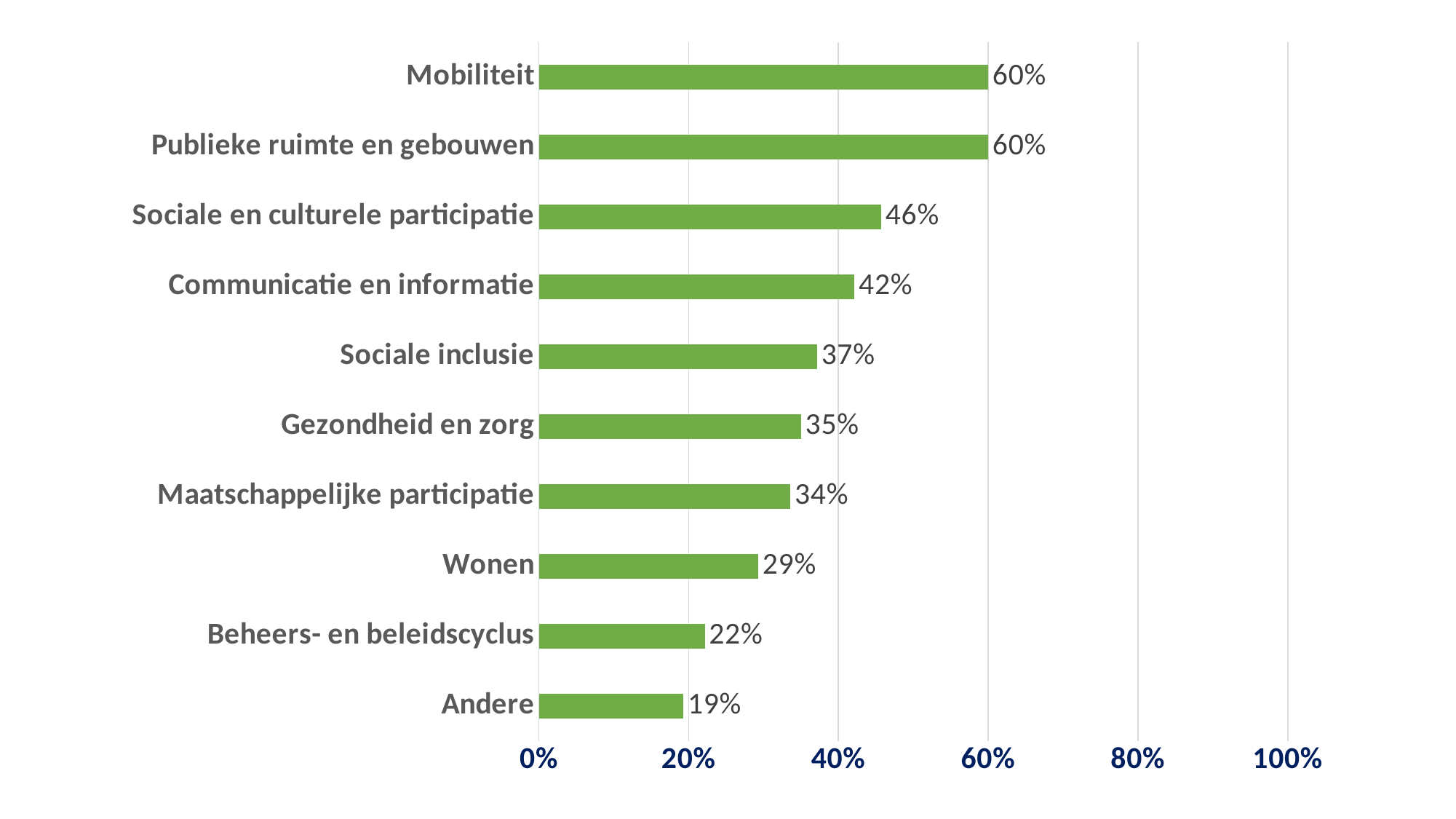
What colour are the bars in the chart? green Is the value for Maatschappelijke participatie greater or less than 40%? less What is the value for Wonen? 29% What is the value for Sociale en culturele participatie? 46% What is the difference between the values for Communicatie en informatie and Sociale inclusie? 5% What is the value for Gezondheid en zorg? 35% Which category has the lowest value? Andere Which is larger, the value for Sociale inclusie or the value for Wonen? Sociale inclusie What is the difference between the values for Mobiliteit and Andere? 41% What kind of chart is this? bar chart What is the value for Beheers- en beleidscyclus? 22% How many categories are shown in the chart? 10